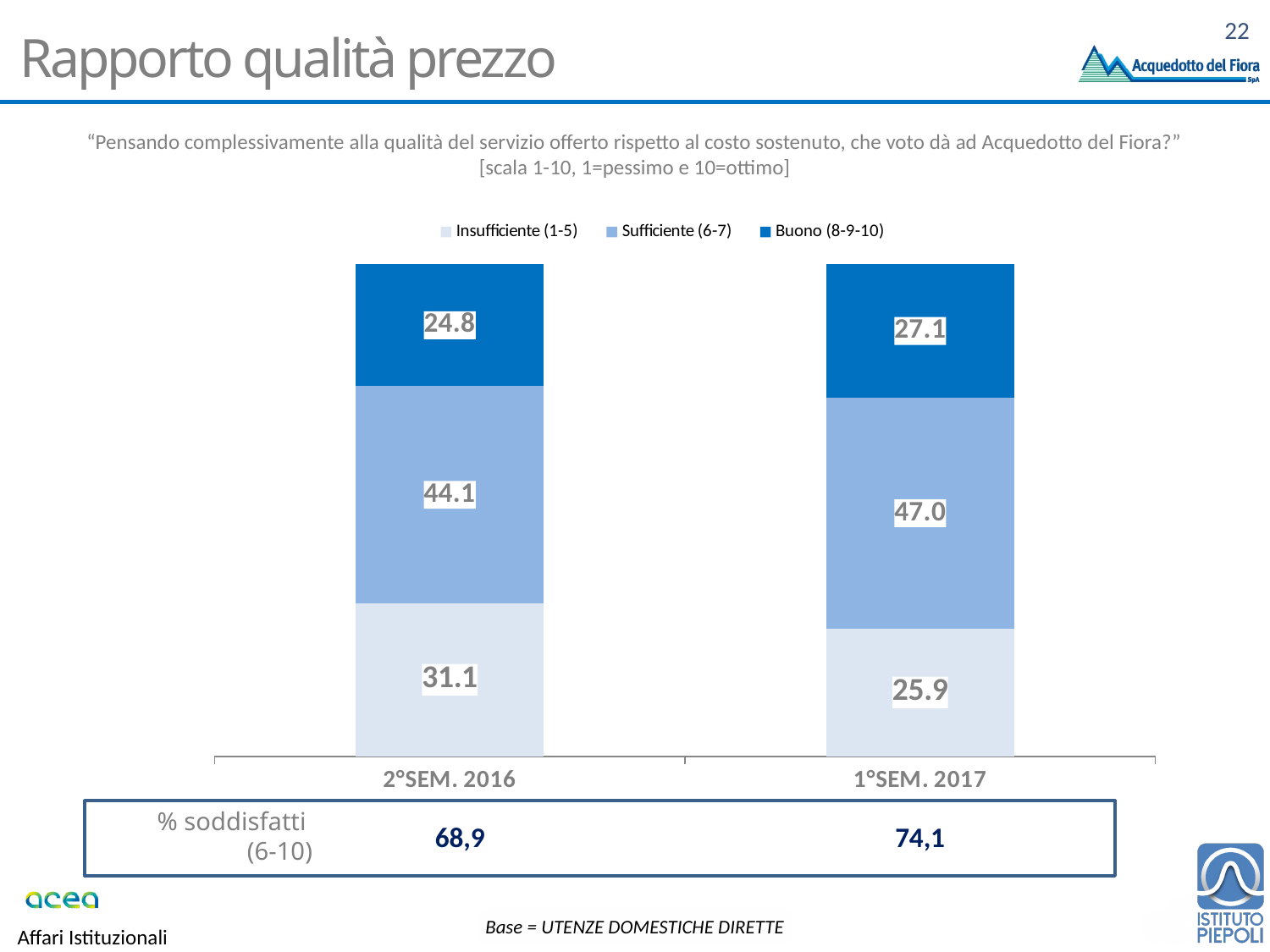
What kind of chart is shown on the slide? Stacked bar chart How many series does the legend list? 3 Which category has the higher value for Insufficiente (1-5), 2°SEM. 2016 or 1°SEM. 2017? 2°SEM. 2016 What is the value for Buono (8-9-10) in 2°SEM. 2016? 24.8 Which segment is the largest in the 1°SEM. 2017 bar? Sufficiente (6-7) What is the total of the stacked bar for 2°SEM. 2016? 100.0 How many categories are shown on the x axis? 2 What is the value for Insufficiente (1-5) in 1°SEM. 2017? 25.9 Which segment is the smallest in the 2°SEM. 2016 bar? Buono (8-9-10) What is the difference between the Sufficiente (6-7) values for 1°SEM. 2017 and 2°SEM. 2016? 2.9 What is the value for Sufficiente (6-7) in 1°SEM. 2017? 47.0 What is the difference between the Insufficiente (1-5) values for 2°SEM. 2016 and 1°SEM. 2017? 5.2